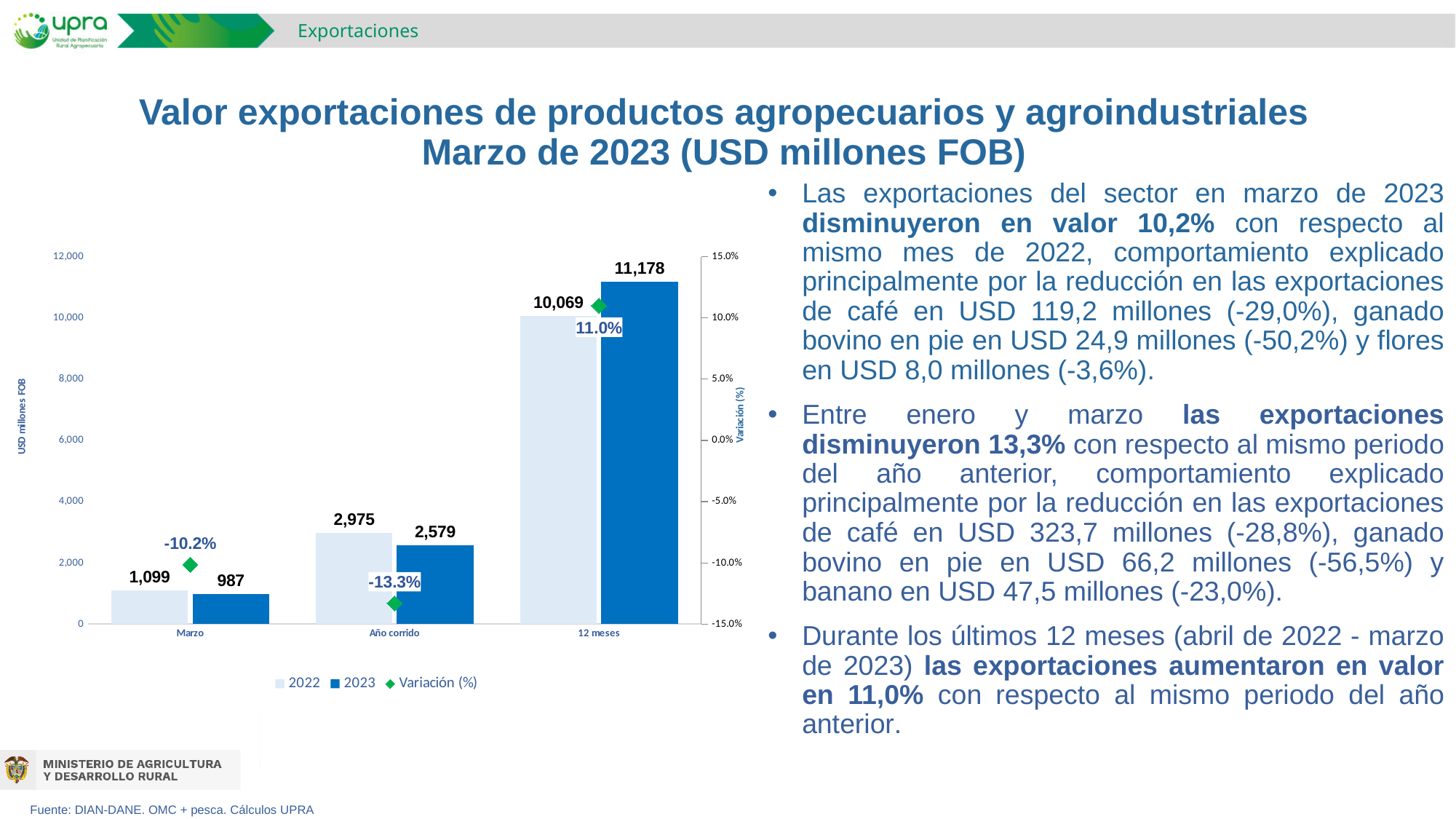
Is the 2023 value for Año corrido greater or less than 4,000? less How many series does the legend list? 3 What is the difference between the 2022 and 2023 values for 12 meses? 1,109 What is the 2022 value for Marzo? 1,099 How many categories are shown on the x axis? 3 What is the 2023 value for Año corrido? 2,579 What is the label of the left vertical axis? USD millones FOB Which category has the lowest 2022 value? Marzo What is the Variación (%) value for 12 meses? 11.0% What kind of chart is used to show the 2022 and 2023 values? bar chart Which is larger for Marzo, the 2022 value or the 2023 value? 2022 Which category has the highest 2023 value? 12 meses